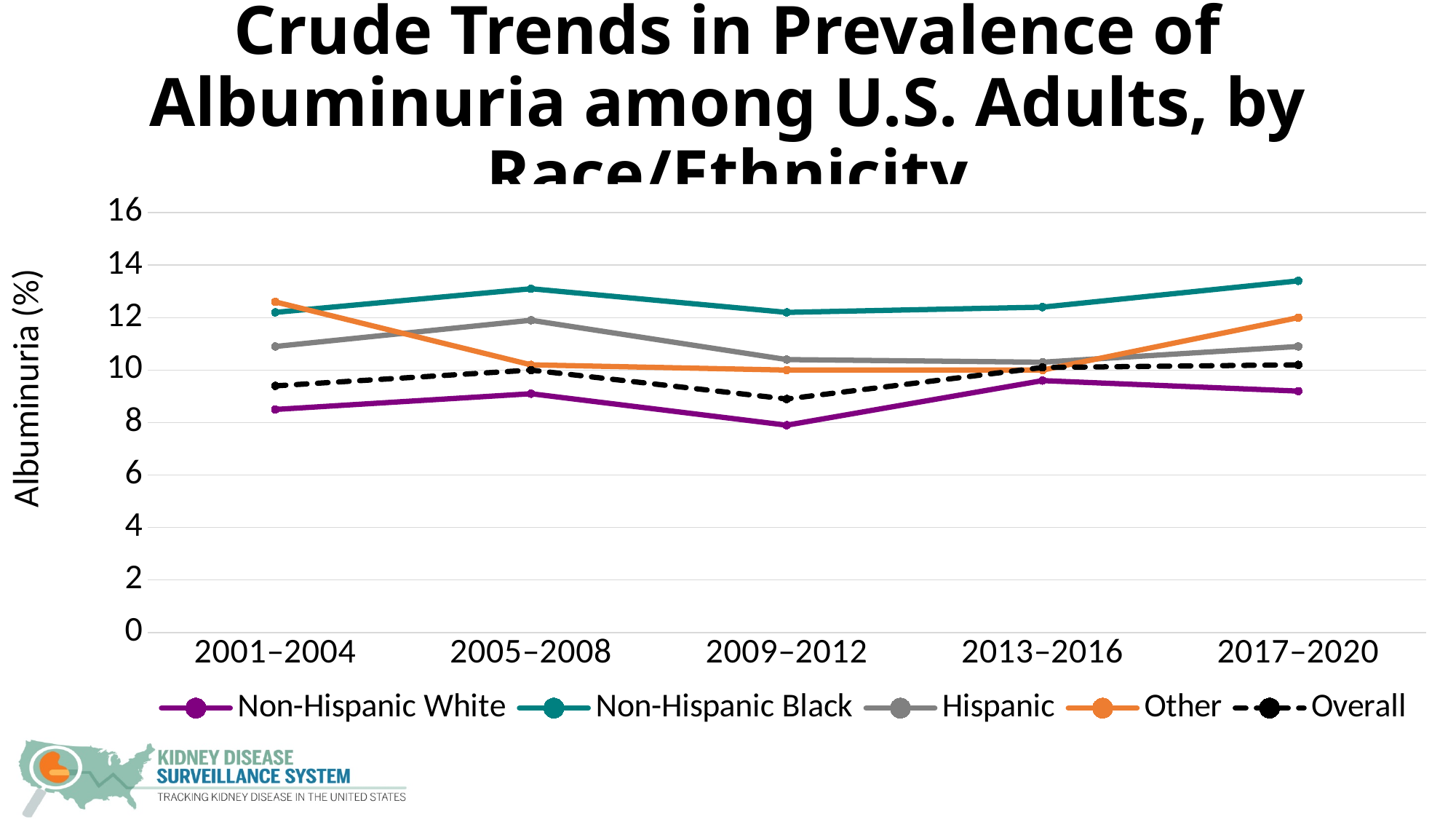
How many time periods are shown on the x axis? 5 Which group has the lowest albuminuria prevalence in 2009–2012? Non-Hispanic White In 2001–2004, which is larger: the value for Other or the value for Hispanic? Other In 2017–2020, which is larger: the value for Other or the value for Non-Hispanic White? Other What kind of chart is shown on the slide? line chart Is the value for Non-Hispanic Black in 2005–2008 greater or less than 12? greater Which group's line is the lowest across all five periods? Non-Hispanic White Which group has the highest albuminuria prevalence in 2017–2020? Non-Hispanic Black Is the value for Non-Hispanic White in 2009–2012 greater or less than 10? less How many series does the legend list? 5 Which series is drawn with a dashed line? Overall Does the Non-Hispanic Black line rise or fall from 2013–2016 to 2017–2020? rise